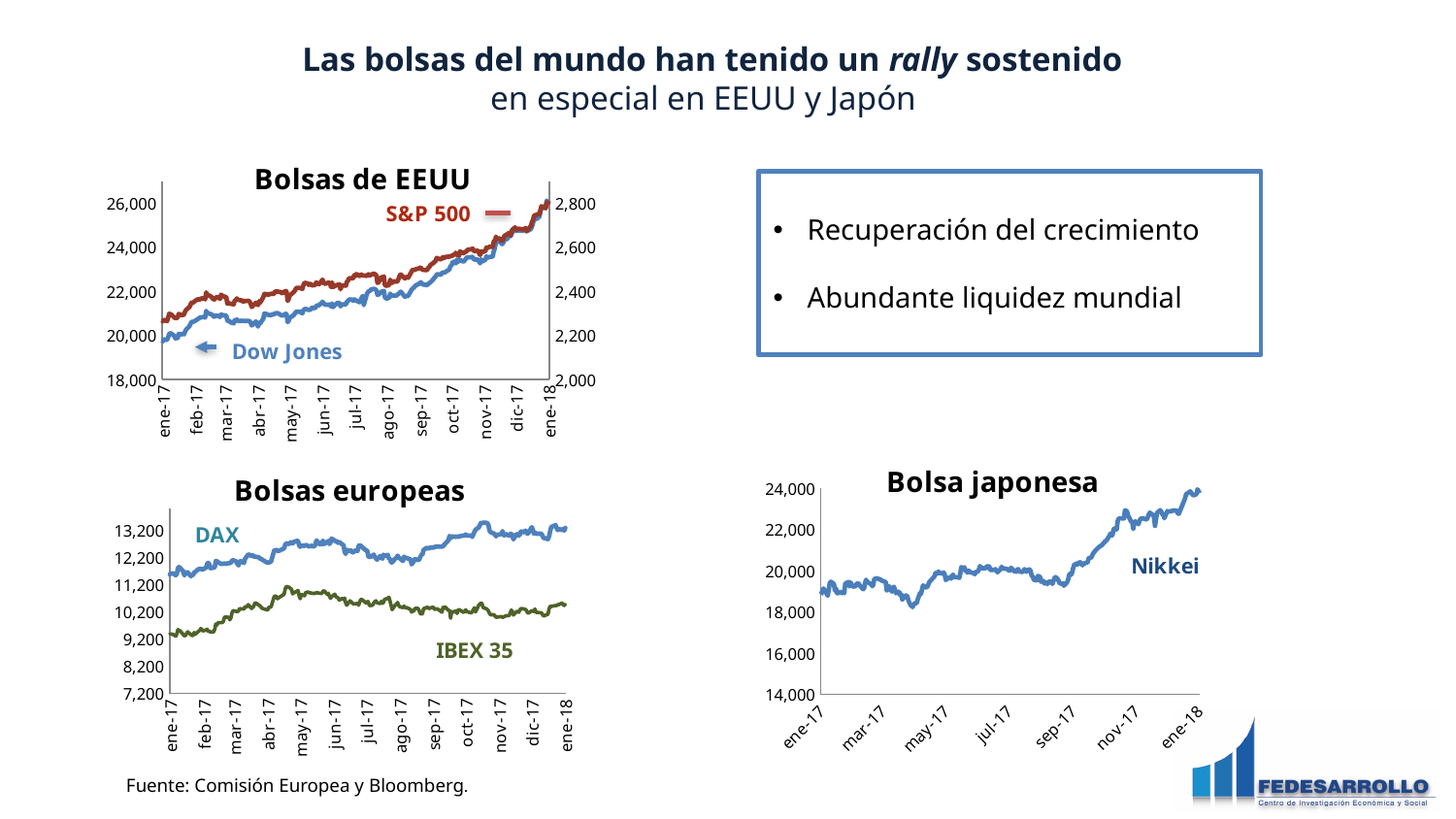
How many series are plotted in the "Bolsas de EEUU" chart? 2 In the "Bolsas europeas" chart, is the DAX value at ene-18 greater or less than 12,200? greater Which two series are shown in the "Bolsas europeas" chart? DAX and IBEX 35 What kind of chart is the "Bolsas de EEUU" chart? Line chart In the "Bolsa japonesa" chart, is the Nikkei value at ene-17 greater or less than 20,000? less How many series are plotted in the "Bolsa japonesa" chart? 1 In the "Bolsas europeas" chart, which series has higher values throughout the period, DAX or IBEX 35? DAX In the "Bolsas de EEUU" chart, is the Dow Jones value at ene-18 greater or less than 24,000? greater In the "Bolsa japonesa" chart, does the Nikkei rise or fall from ene-17 to ene-18? Rise In the "Bolsas de EEUU" chart, does the Dow Jones rise or fall from ene-17 to ene-18? Rise